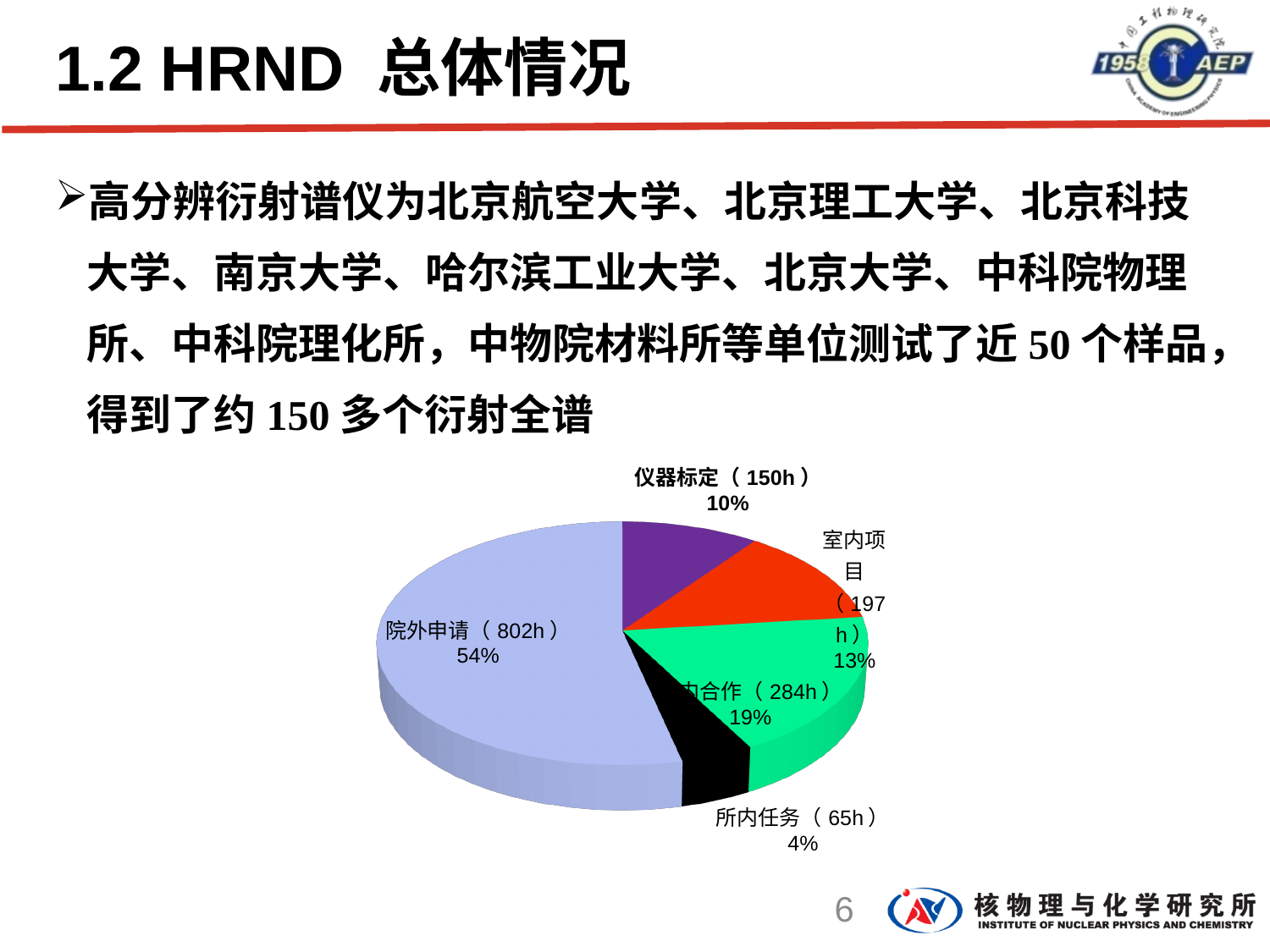
How many slices does the pie chart have? 5 What share of the pie does 院外申请 account for? 54% What percentage is shown for the slice labelled 284h? 19% What kind of chart is shown on the slide? pie chart Which category has the smallest slice of the pie? 所内任务 How many hours are shown for 院外申请 in the pie chart? 802h What percentage of the pie is 所内任务? 4% Which has more hours, 室内项目 or 仪器标定? 室内项目 What is the difference in hours between 室内项目 and 仪器标定? 47h How many hours are shown for 仪器标定? 150h Which category has the largest slice of the pie? 院外申请